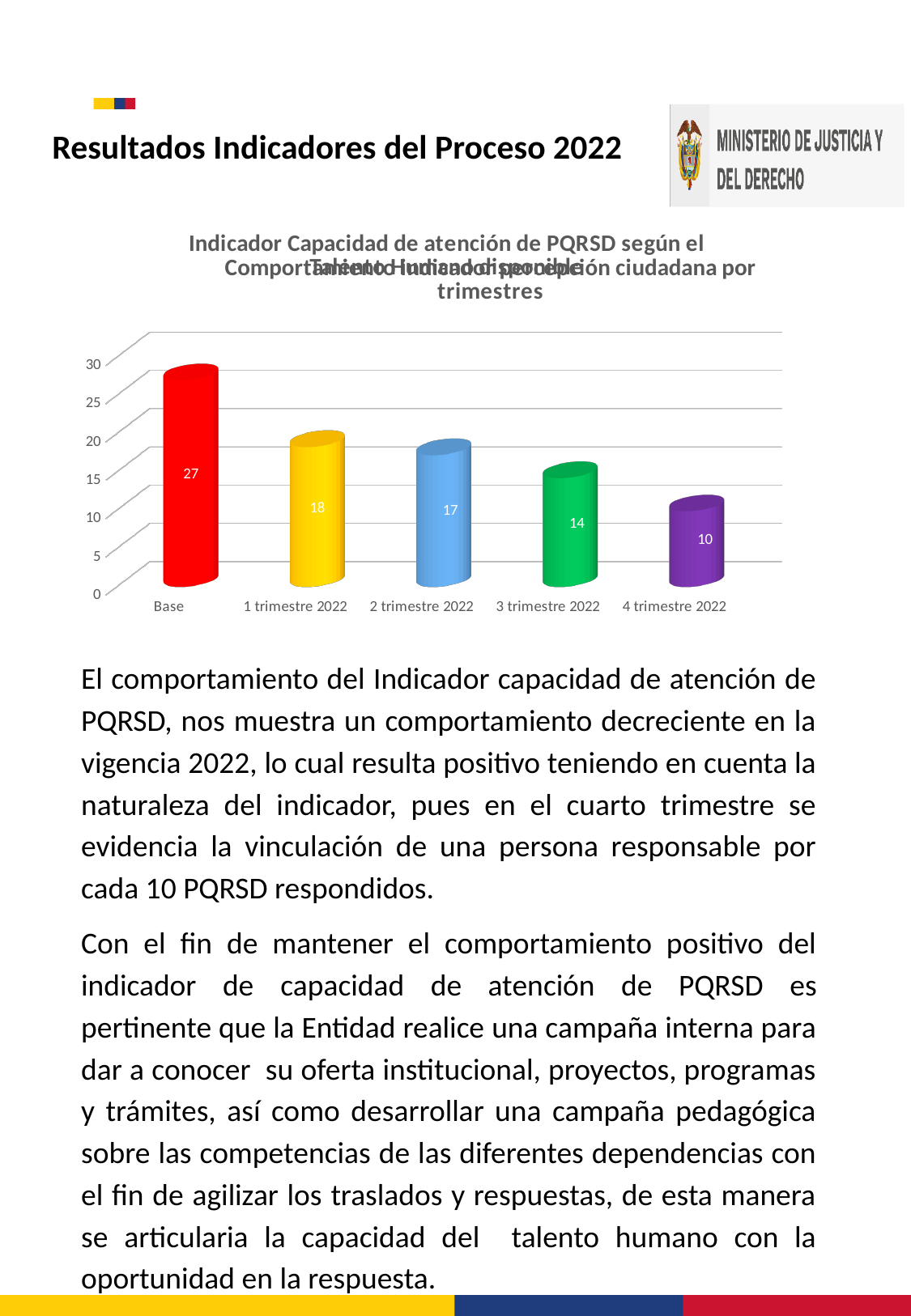
Which category has the highest value? Base Do the values rise or fall from Base to 4 trimestre 2022? Fall Which is larger, the value for 2 trimestre 2022 or the value for 3 trimestre 2022? 2 trimestre 2022 How many categories are shown on the x axis? 5 What is the difference between the values for 1 trimestre 2022 and 2 trimestre 2022? 1 What is the difference between the values for Base and 4 trimestre 2022? 17 What is the value for 3 trimestre 2022? 14 Which category has the lowest value? 4 trimestre 2022 What is the value for 1 trimestre 2022? 18 What is the value for 4 trimestre 2022? 10 What kind of chart is shown on the slide? Bar chart What is the value for Base? 27